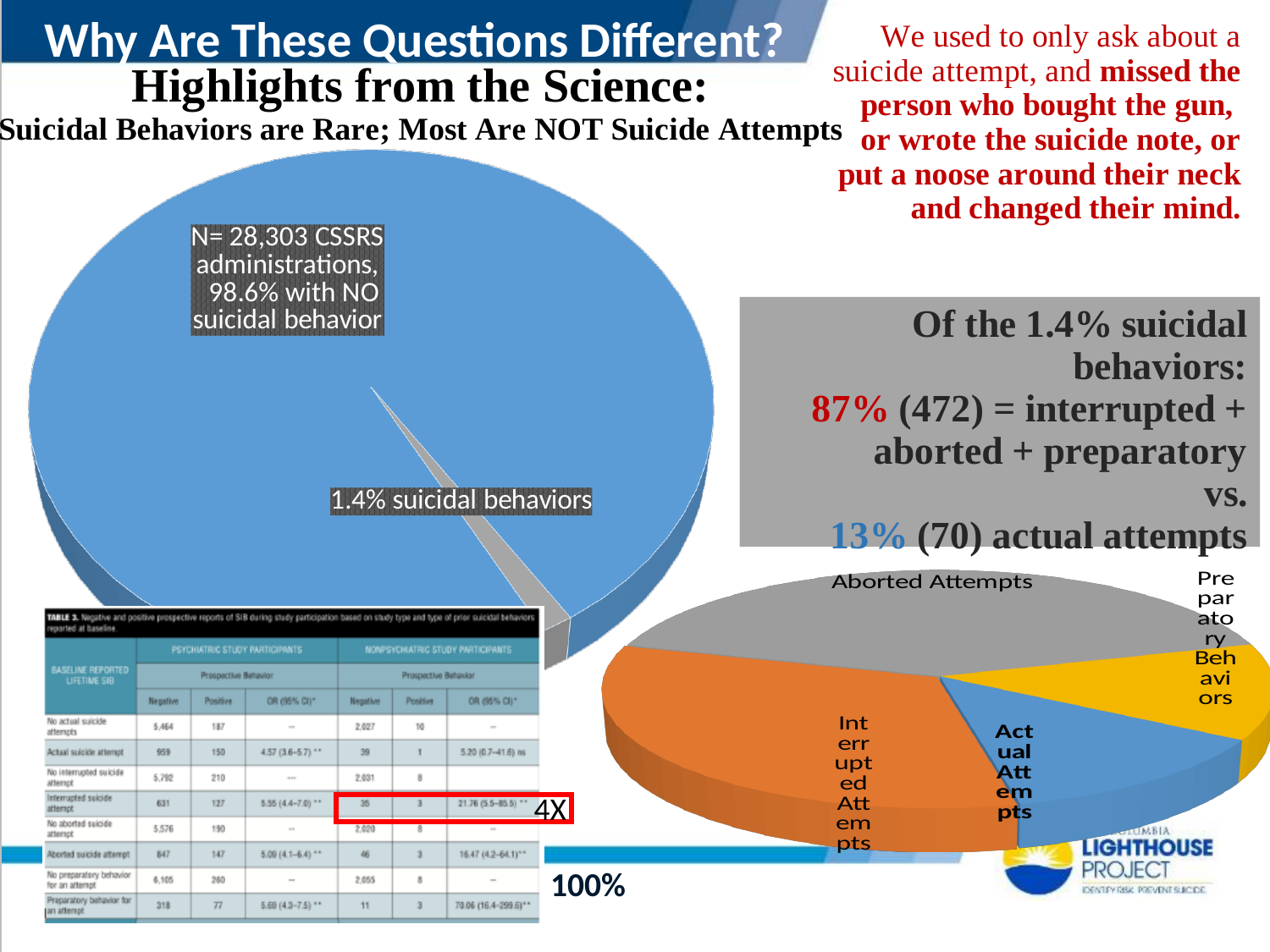
In the large pie chart on the left, what share of CSSRS administrations had NO suicidal behavior? 98.6% In the smaller pie chart at the bottom right, which slice is larger: Interrupted Attempts or Actual Attempts? Interrupted Attempts In the large pie chart on the left, what share of CSSRS administrations had suicidal behaviors? 1.4% What kind of chart is the smaller chart at the bottom right of the slide? Pie chart How many slices does the smaller pie chart at the bottom right have? 4 How many slices does the large pie chart on the left have? 2 In the large pie chart on the left, which slice is larger: NO suicidal behavior or suicidal behaviors? NO suicidal behavior What kind of chart is the large chart on the left of the slide? Pie chart In the smaller pie chart at the bottom right, what colour is the Aborted Attempts slice? Gray In the large pie chart on the left, how many CSSRS administrations (N) does the chart represent? 28,303